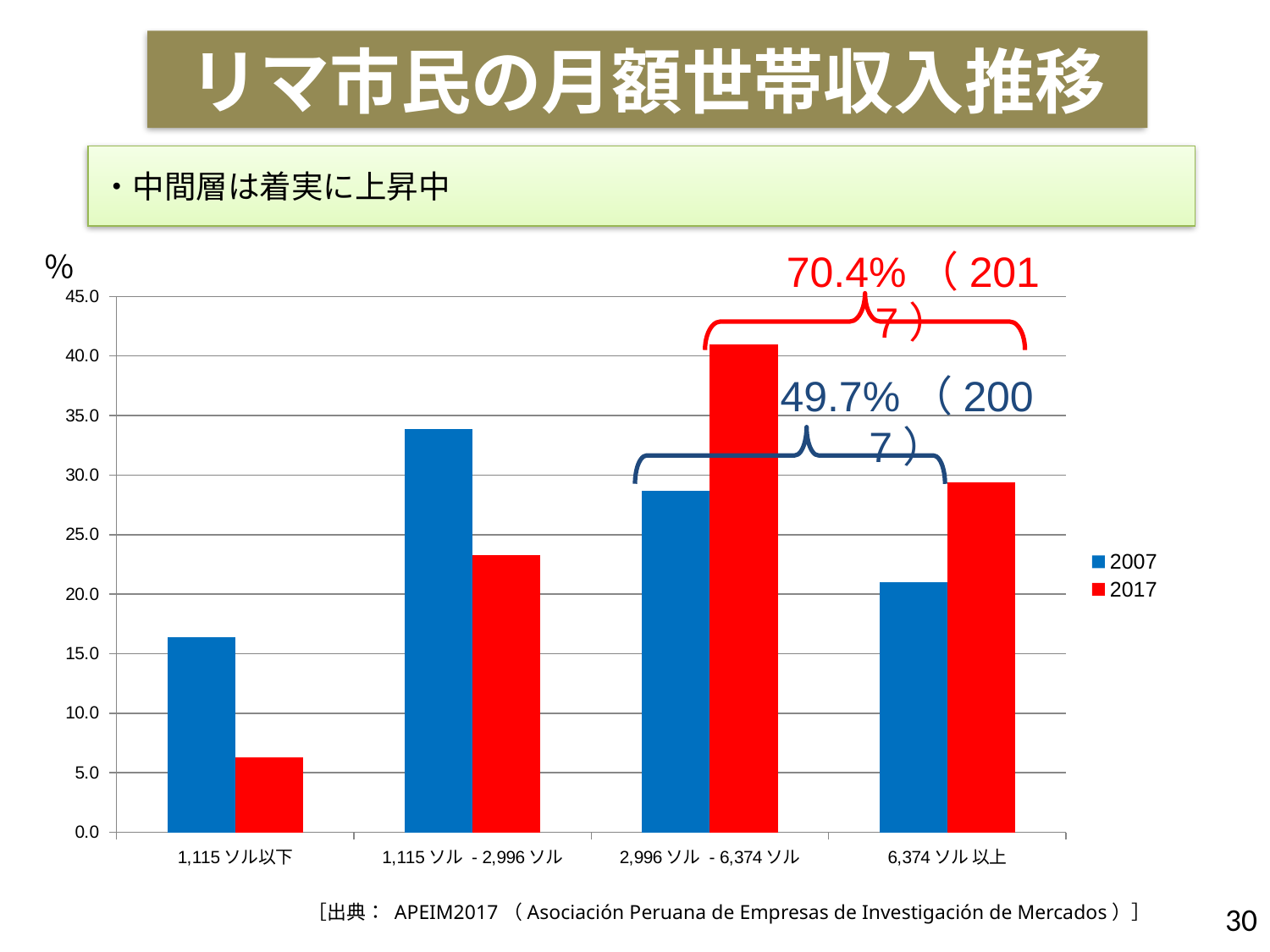
What kind of chart is shown on the slide? bar chart How many income categories are shown on the x axis of the chart? 4 Is the 2017 value for 1,115 ソル以下 greater or less than 10.0? less Which income category has the highest value for the 2007 series? 1,115 ソル - 2,996 ソル Which income category has the highest value for the 2017 series? 2,996 ソル - 6,374 ソル Is the 2017 value for 2,996 ソル - 6,374 ソル greater or less than 35.0? greater For the category 1,115 ソル以下, which series has the larger value, 2007 or 2017? 2007 How many series does the chart legend list? 2 For the category 6,374 ソル 以上, which series has the larger value, 2007 or 2017? 2017 Is the 2007 value for 1,115 ソル - 2,996 ソル greater or less than 30.0? greater Which income category has the lowest value for the 2017 series? 1,115 ソル以下 According to the annotation on the chart, what combined percentage is shown for the two highest income categories in 2017? 70.4%